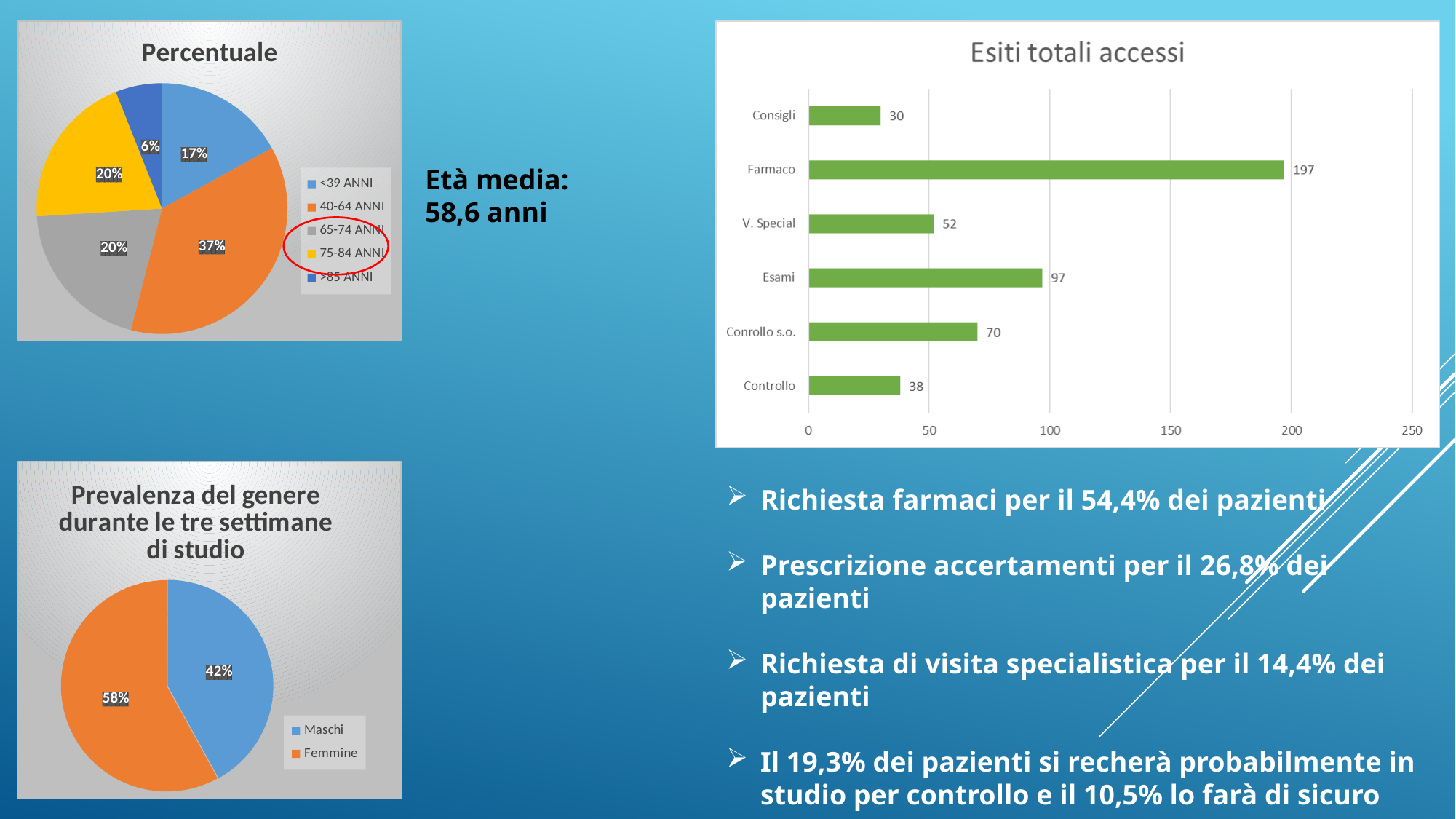
In the 'Esiti totali accessi' chart, which category has the highest value? Farmaco In the 'Prevalenza del genere durante le tre settimane di studio' pie chart, what share is Femmine? 58% In the 'Esiti totali accessi' chart, which is larger, the value for V. Special or the value for Conrollo s.o.? Conrollo s.o. What kind of chart is 'Esiti totali accessi'? Bar chart How many categories are shown in the 'Esiti totali accessi' chart? 6 In the 'Esiti totali accessi' chart, what is the difference between the values for Esami and Controllo? 59 In the 'Esiti totali accessi' chart, what is the value for Esami? 97 How many entries does the legend of the 'Percentuale' pie chart list? 5 In the 'Esiti totali accessi' chart, which category has the lowest value? Consigli In the 'Esiti totali accessi' chart, what is the value for Farmaco? 197 In the 'Percentuale' pie chart, which age group has the smallest share? >85 ANNI In the 'Percentuale' pie chart, what share does the 40-64 ANNI group have? 37%